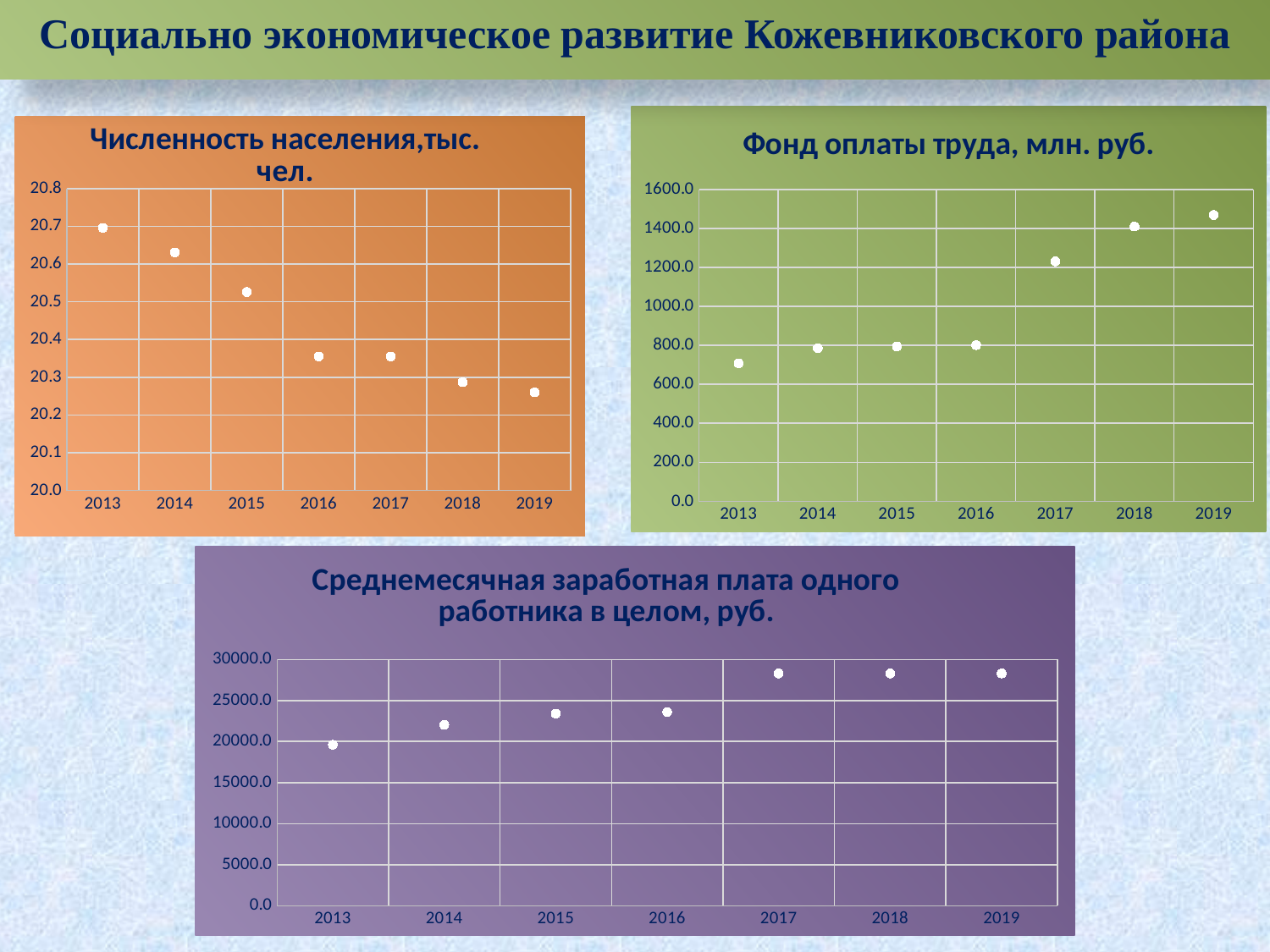
On the 'Фонд оплаты труда, млн. руб.' chart, which year has the highest value? 2019 On the 'Численность населения, тыс. чел.' chart, is the value for 2019 greater or less than 20.3? less On the 'Среднемесячная заработная плата одного работника в целом, руб.' chart, which year has the lowest value? 2013 On the 'Фонд оплаты труда, млн. руб.' chart, do the values rise or fall from 2013 to 2019? rise On the 'Численность населения, тыс. чел.' chart, which year has the highest value? 2013 What kind of chart is the 'Численность населения, тыс. чел.' chart? scatter chart On the 'Фонд оплаты труда, млн. руб.' chart, is the value for 2017 greater or less than 1200.0? greater On the 'Численность населения, тыс. чел.' chart, do the values rise or fall from 2013 to 2019? fall How many years are plotted on the 'Фонд оплаты труда, млн. руб.' chart? 7 On the 'Фонд оплаты труда, млн. руб.' chart, which year has the lowest value? 2013 On the 'Среднемесячная заработная плата одного работника в целом, руб.' chart, which is larger, the value for 2014 or the value for 2017? 2017